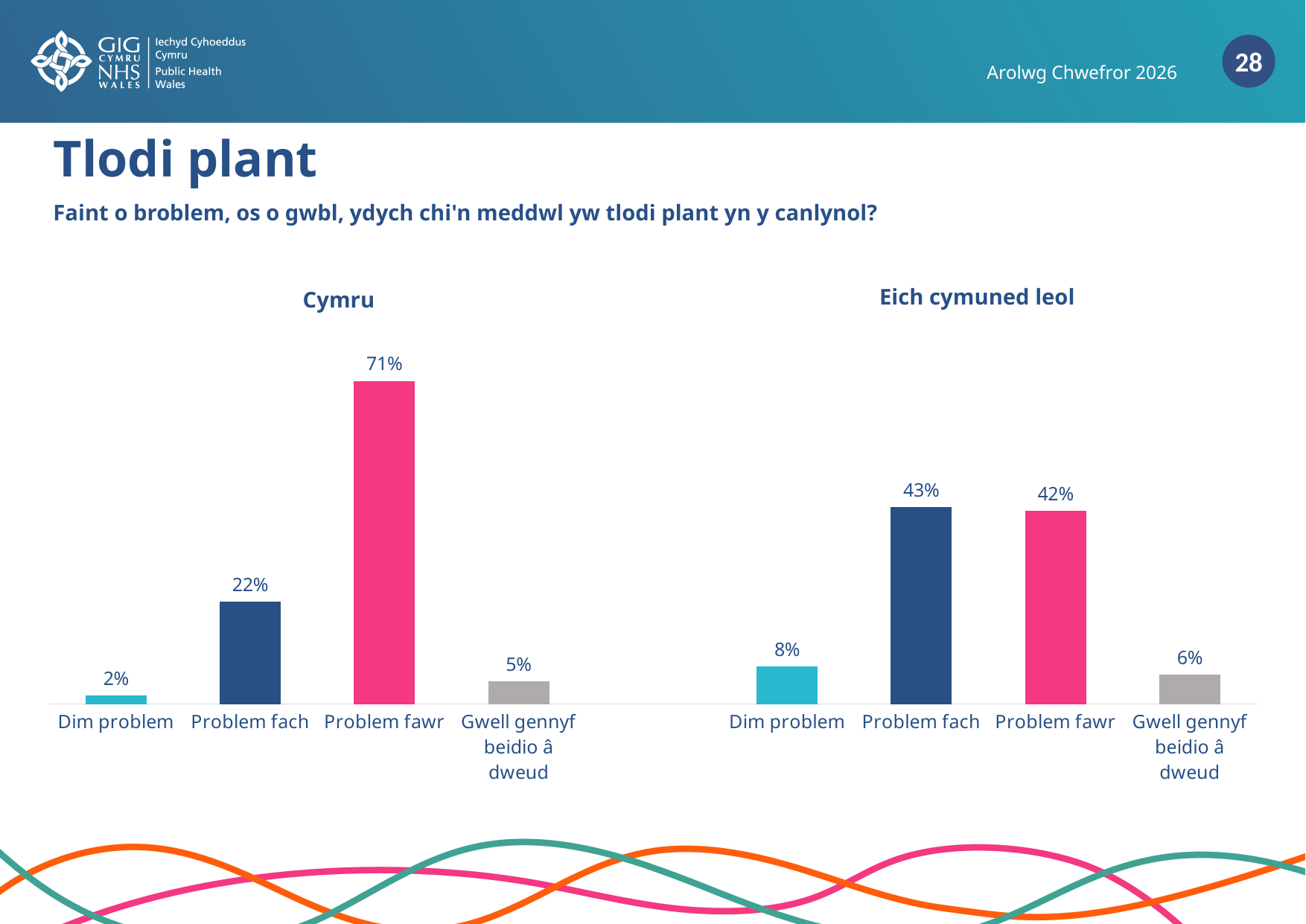
How many categories are shown in the 'Eich cymuned leol' chart? 4 What type of chart is the 'Cymru' chart? Bar chart In the 'Cymru' chart, which category has the highest value? Problem fawr In the 'Eich cymuned leol' chart, what is the value for 'Dim problem'? 8% In the 'Cymru' chart, what is the value for 'Problem fawr'? 71% In the 'Cymru' chart, what is the difference between 'Problem fawr' and 'Problem fach'? 49% In the 'Cymru' chart, which category has the lowest value? Dim problem In the 'Cymru' chart, which is larger: 'Problem fach' or 'Gwell gennyf beidio â dweud'? Problem fach In the 'Eich cymuned leol' chart, what is the value for 'Gwell gennyf beidio â dweud'? 6% What is the title of the chart on the right of the slide? Eich cymuned leol In the 'Eich cymuned leol' chart, which category has the lowest value? Gwell gennyf beidio â dweud What is the difference between the 'Problem fawr' value in the 'Cymru' chart and the 'Problem fawr' value in the 'Eich cymuned leol' chart? 29%